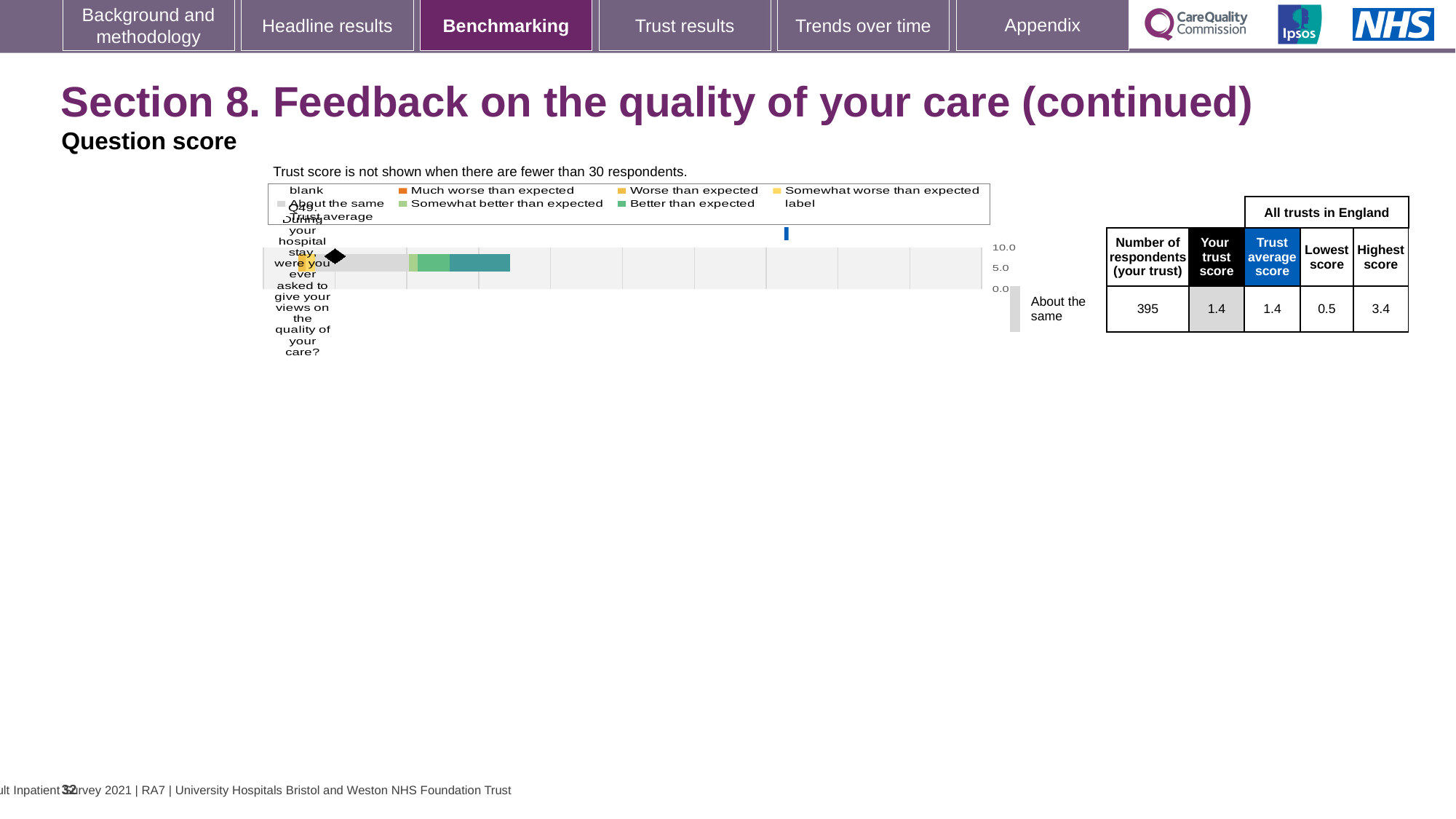
What kind of chart is shown on the slide? bar chart What is the highest score across all trusts in England for Q49? 3.4 What is the lowest score across all trusts in England for Q49? 0.5 What is the trust score for Q49 shown in the table next to the chart? 1.4 Is the trust score for Q49 greater or less than 5.0? less What is the difference between the highest and lowest scores for Q49 across all trusts in England? 2.9 How many questions are plotted in the chart? 1 What is the trust average score for Q49? 1.4 Which benchmark category is the trust's score for Q49 placed in? About the same What colour represents 'Much worse than expected' in the chart legend? orange Which question is plotted in the chart? Q49. During your hospital stay, were you ever asked to give your views on the quality of your care? How many respondents from the trust answered Q49? 395